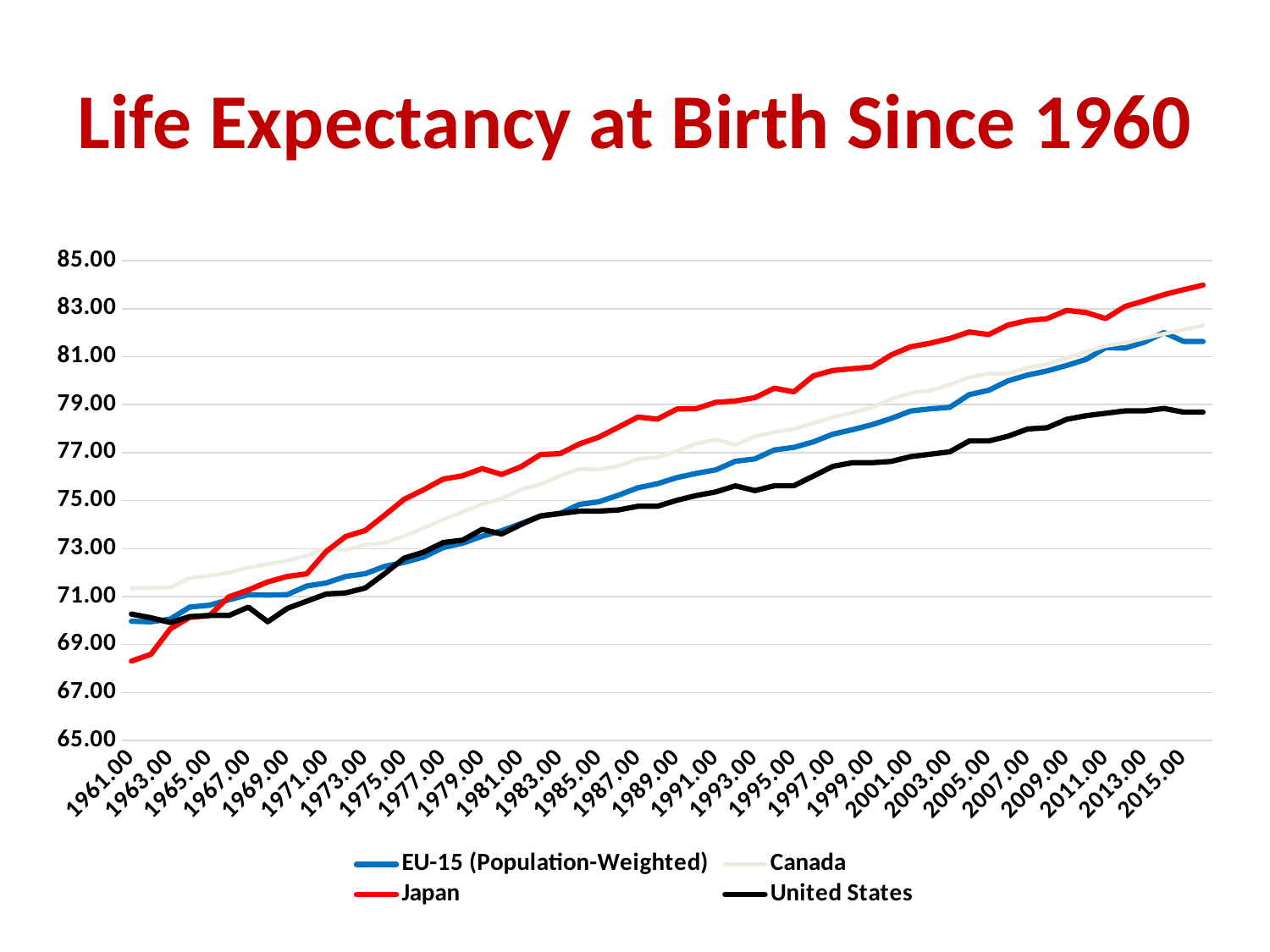
Which series has the highest life expectancy at the right end of the chart (around 2015)? Japan Which series has the lowest life expectancy at the right end of the chart (around 2015)? United States Is the value for Japan in 2015 greater or less than 83.00? greater In 1961, which is larger: the value for Canada or the value for Japan? Canada How many series does the legend list? 4 Around 2015, which is larger: the value for Japan or the value for the United States? Japan Do the life expectancy values generally rise or fall from 1961 to 2015? rise What kind of chart is shown on the slide? line chart What is the title of the chart? Life Expectancy at Birth Since 1960 Is the value for the United States in 2015 greater or less than 77.00? greater Is the value for Japan in 1961 greater or less than 69.00? less Which series has the lowest life expectancy at the start of the chart in 1961? Japan